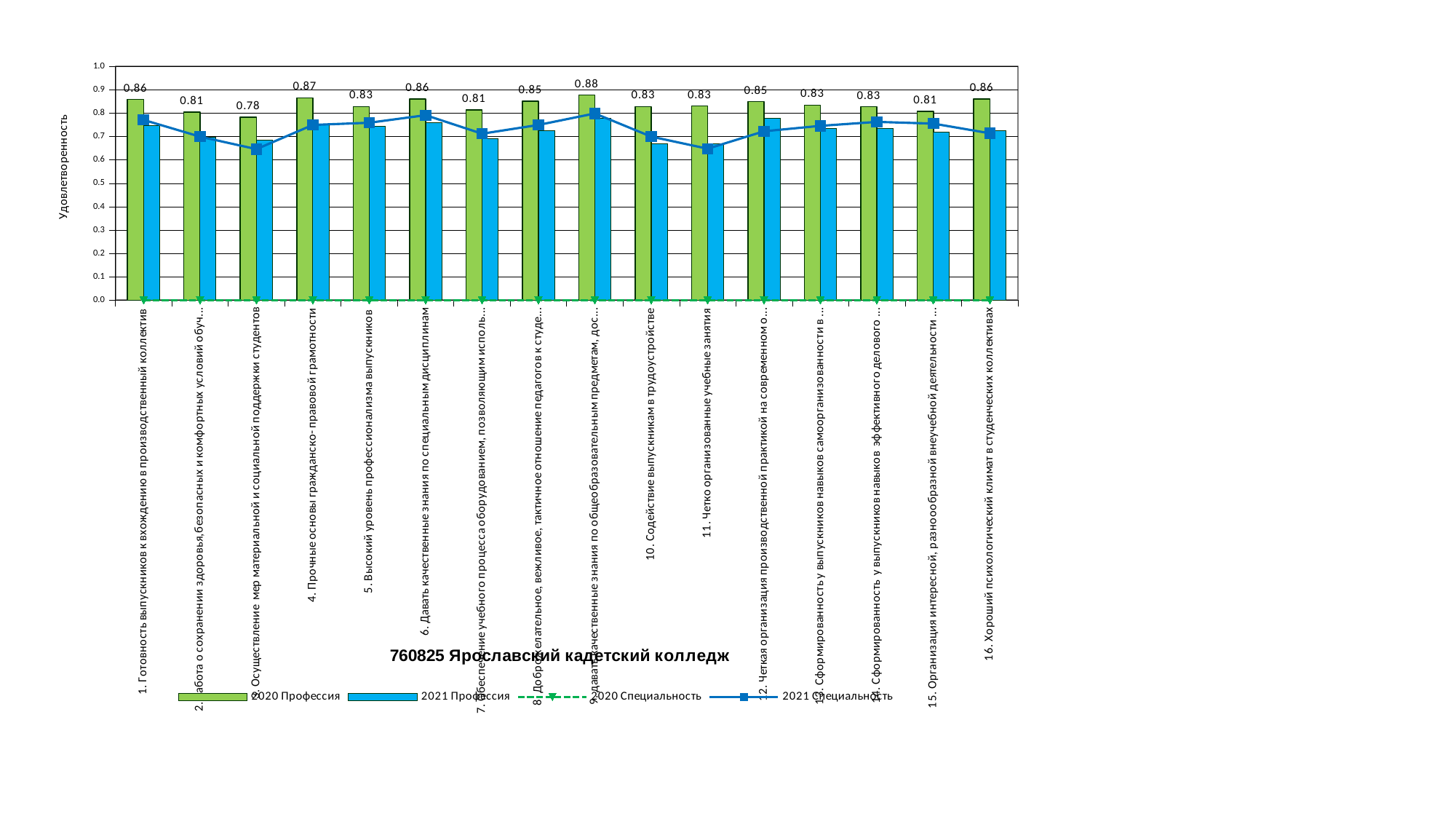
Is the 2021 Профессия value for category 1 (Готовность выпускников к вхождению в производственный коллектив) greater or less than 0.7? greater How many series does the legend list? 4 Which has the larger 2020 Профессия value: category 16 (Хороший психологический климат) or category 10 (Содействие выпускникам в трудоустройстве)? 16. Хороший психологический климат в студенческих коллективах Is the 2021 Профессия value for category 11 (Четко организованные учебные занятия) greater or less than 0.7? less What is the 2020 Профессия value for category 4 (Прочные основы гражданско-правовой грамотности)? 0.87 How many categories are shown on the x axis? 16 What is the difference between the 2020 Профессия values for category 4 and category 3? 0.09 What is the 2020 Профессия value for category 1 (Готовность выпускников к вхождению в производственный коллектив)? 0.86 What is the 2020 Профессия value for category 3 (Осуществление мер материальной и социальной поддержки студентов)? 0.78 Which category has the lowest 2020 Профессия value? 3. Осуществление мер материальной и социальной поддержки студентов What is the 2020 Профессия value for category 16 (Хороший психологический климат в студенческих коллективах)? 0.86 What is the title of the chart? 760825 Ярославский кадетский колледж